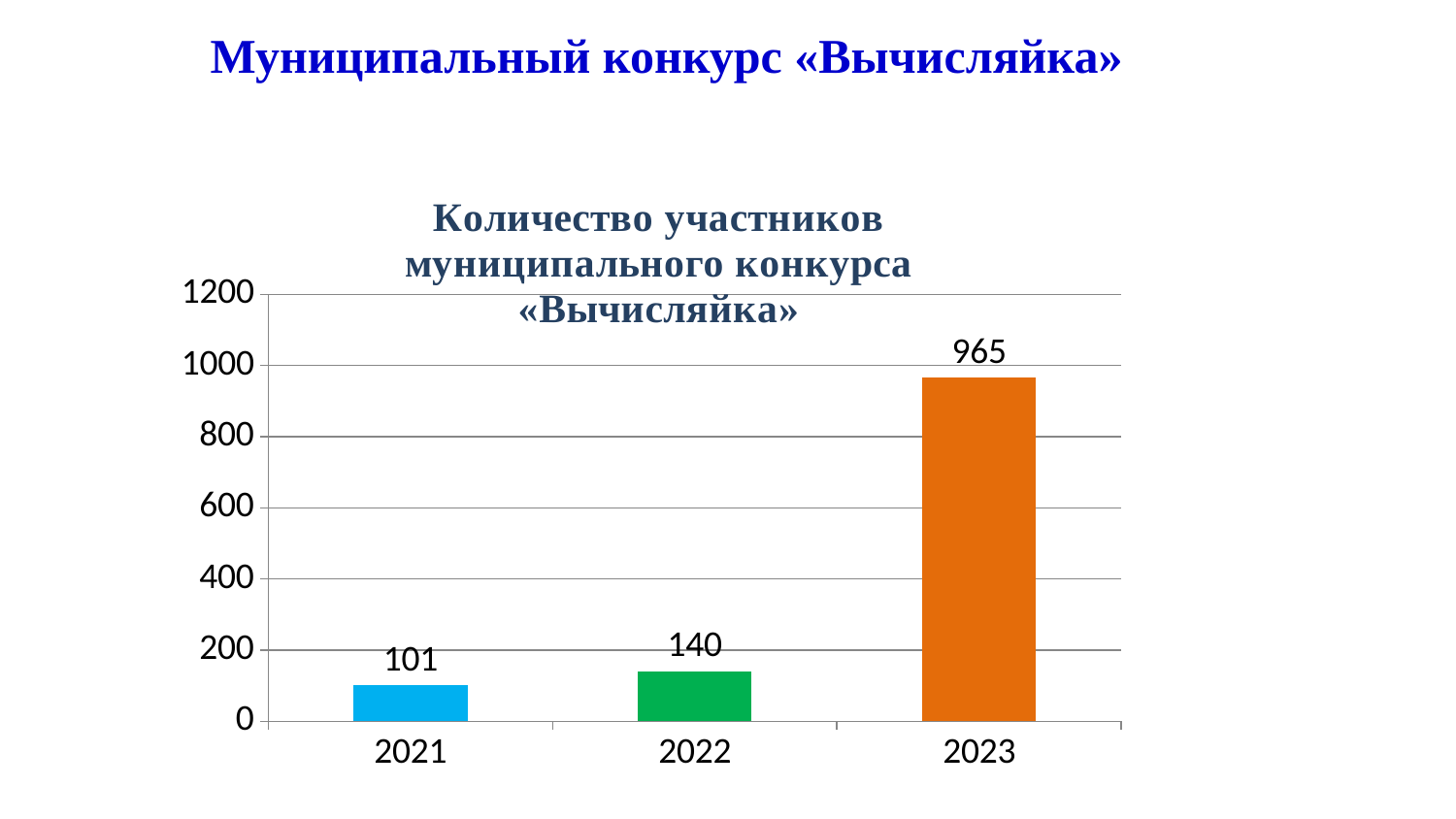
What is the difference between the number of participants in 2023 and 2022? 825 Which year has more participants, 2021 or 2022? 2022 Do the values rise or fall from 2021 to 2023? Rise What is the number of participants in 2021? 101 Which year has the lowest number of participants? 2021 What is the number of participants in 2023? 965 Is the value for 2023 greater or less than 800? greater How many years are shown on the chart? 3 Which year has the highest number of participants? 2023 What is the number of participants in 2022? 140 What kind of chart is shown on the slide? Bar chart What is the difference between the number of participants in 2022 and 2021? 39